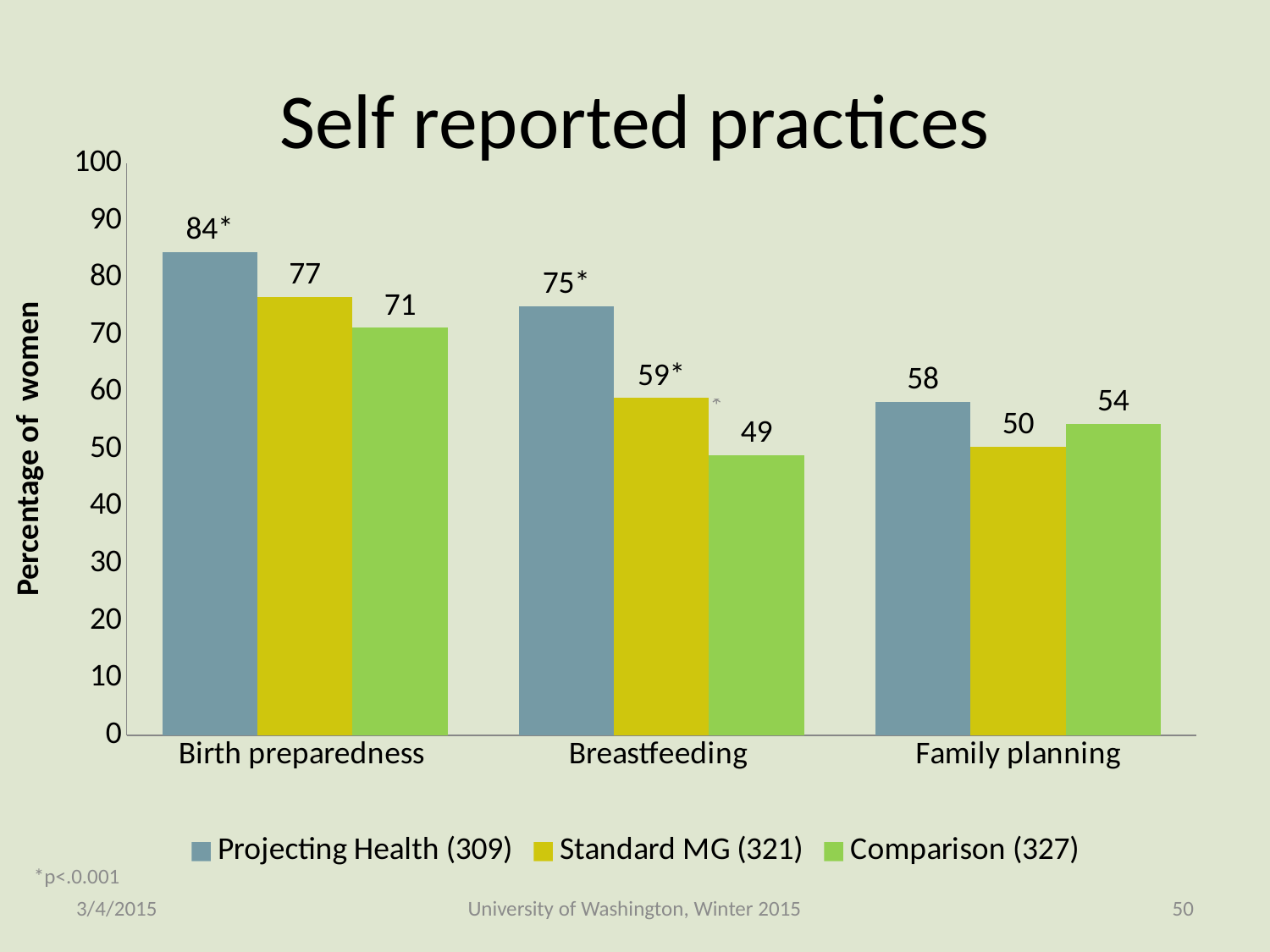
What is the value for Projecting Health (309) in the Family planning category? 58 How many series does the legend list? 3 What is the value for Standard MG (321) in the Birth preparedness category? 77 What is the value for Comparison (327) in the Breastfeeding category? 49 What is the title of the chart? Self reported practices What is the value for Standard MG (321) in the Family planning category? 50 Which category has the lowest value for Comparison (327)? Breastfeeding How many categories are shown on the x axis? 3 What is the difference between the Comparison (327) values for Birth preparedness and Family planning? 17 Which category has the highest value for Projecting Health (309)? Birth preparedness In the Family planning category, which is larger: Standard MG (321) or Comparison (327)? Comparison (327) What type of chart is shown on the slide? bar chart